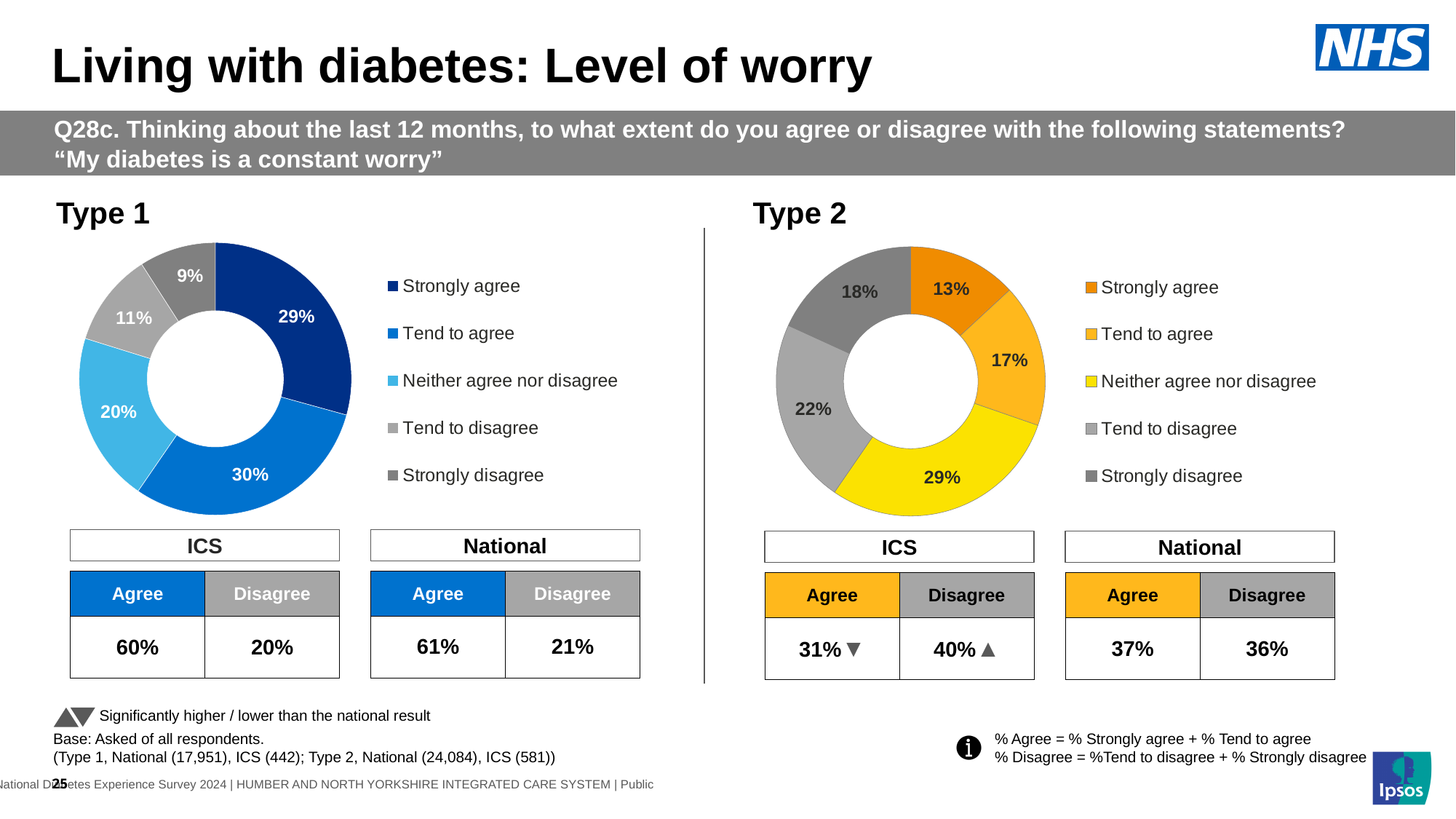
In the Type 1 chart, what is the combined share of Strongly agree and Tend to agree? 59% How many categories does the Type 1 chart show? 5 In the Type 1 chart, what percentage is shown for Strongly disagree? 9% In the Type 2 chart, which category has the smallest share? Strongly agree In the Type 2 chart, what percentage is shown for Neither agree nor disagree? 29% In the Type 1 chart, which category has the largest share? Tend to agree In the Type 1 chart, what percentage is shown for Strongly agree? 29% In the Type 2 chart, what colour represents Neither agree nor disagree? Yellow What kind of chart is the Type 2 chart? Donut chart In the Type 1 chart, which is larger: Neither agree nor disagree or Tend to disagree? Neither agree nor disagree In the Type 2 chart, what percentage is shown for Tend to disagree? 22% In the Type 2 chart, what is the difference in percentage points between Tend to disagree and Strongly disagree? 4